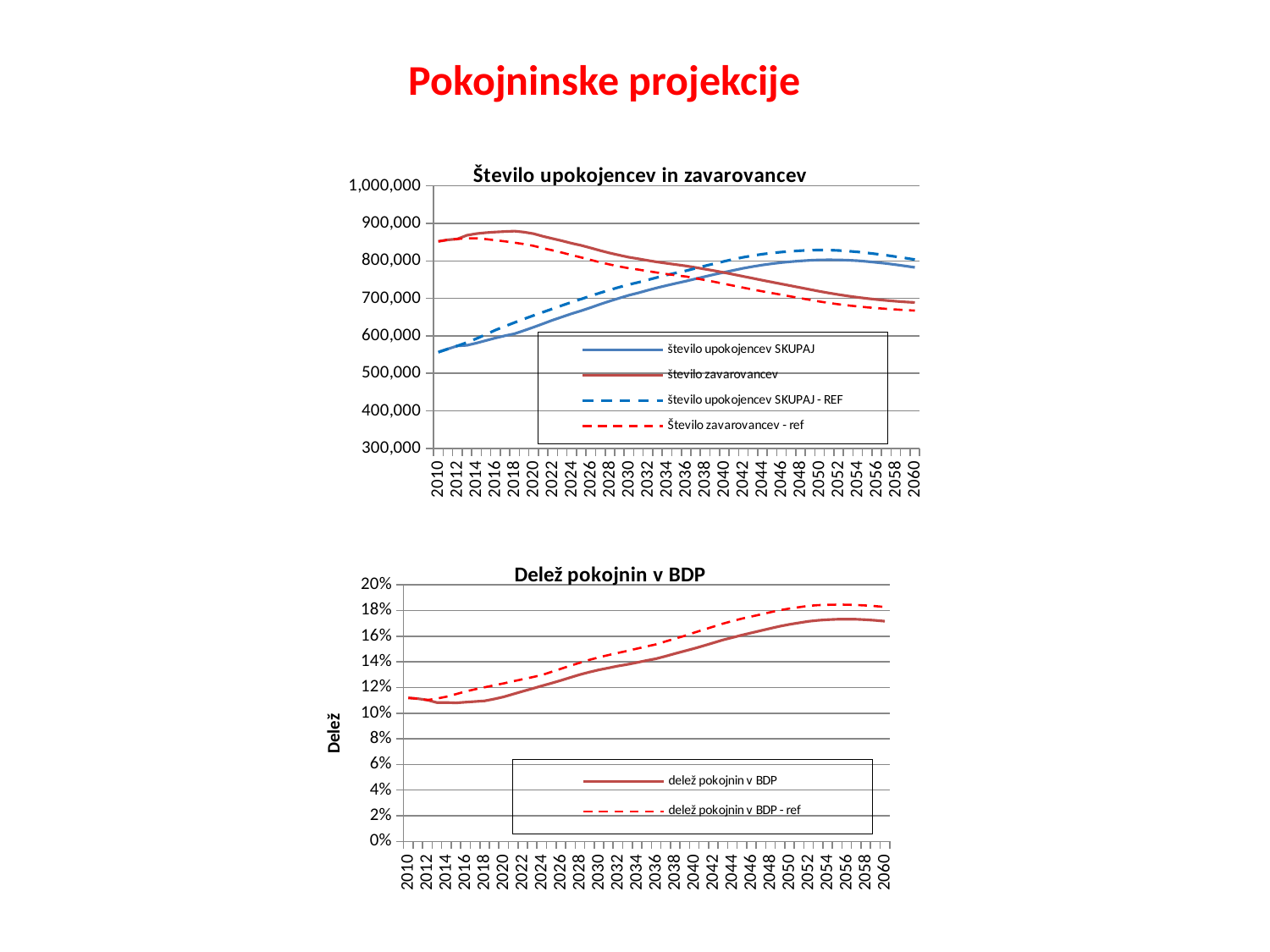
How many series does the legend of the bottom chart 'Delež pokojnin v BDP' list? 2 In the top chart 'Število upokojencev in zavarovancev', is the value for 'število upokojencev SKUPAJ - REF' in 2050 greater or less than 800,000? greater What type of chart is the top chart titled 'Število upokojencev in zavarovancev'? Line chart In the bottom chart 'Delež pokojnin v BDP', does the 'delež pokojnin v BDP' series generally rise or fall from 2010 to 2050? Rise In the top chart 'Število upokojencev in zavarovancev', is the value for 'število zavarovancev' in 2010 greater or less than 800,000? greater What is the label on the vertical axis of the bottom chart 'Delež pokojnin v BDP'? Delež In the bottom chart 'Delež pokojnin v BDP', is the value for 'delež pokojnin v BDP' in 2060 greater or less than 18%? less In the top chart 'Število upokojencev in zavarovancev', does the 'število zavarovancev' series rise or fall between 2020 and 2060? Fall In the top chart 'Število upokojencev in zavarovancev', which series has the higher value in 2060: 'število upokojencev SKUPAJ' or 'število zavarovancev'? število upokojencev SKUPAJ How many series does the legend of the top chart 'Število upokojencev in zavarovancev' list? 4